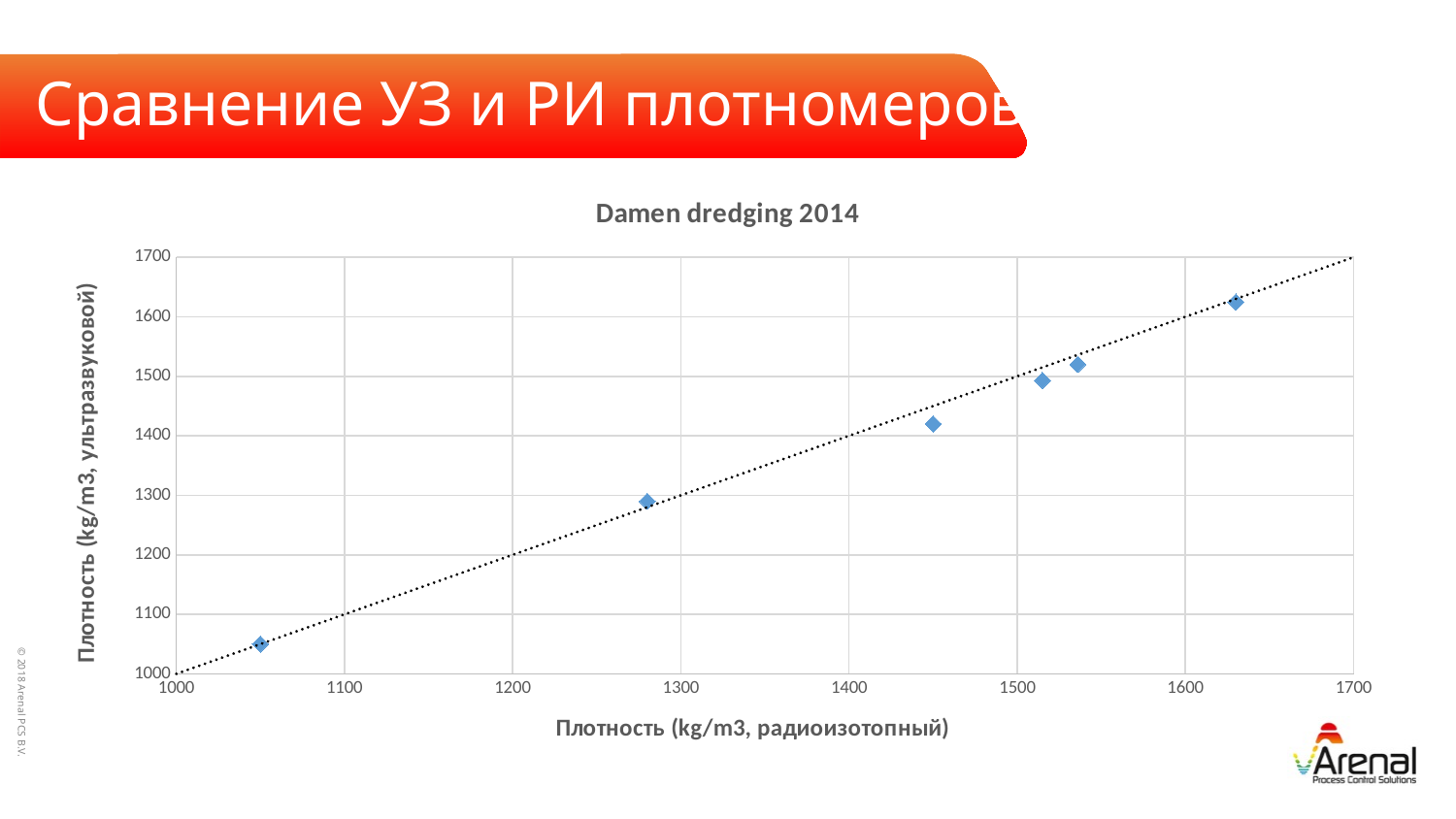
Do the plotted values rise or fall as the x-axis value increases? rise Is the ultrasonic density value for the point at a radioisotope density of about 1280 greater or less than 1200? greater Is the ultrasonic density value for the leftmost point greater or less than 1100? less Which point has the highest ultrasonic density value: the one at a radioisotope density of about 1630 or the one at about 1450? the one at about 1630 What is the title of the chart? Damen dredging 2014 Is the ultrasonic density value for the point at a radioisotope density of about 1630 greater or less than 1600? greater What kind of chart is shown on the slide? scatter chart What is the label of the x axis of the chart? Плотность (kg/m3, радиоизотопный) How many data points are plotted on the chart? 6 What is the maximum value shown on the y axis of the chart? 1700